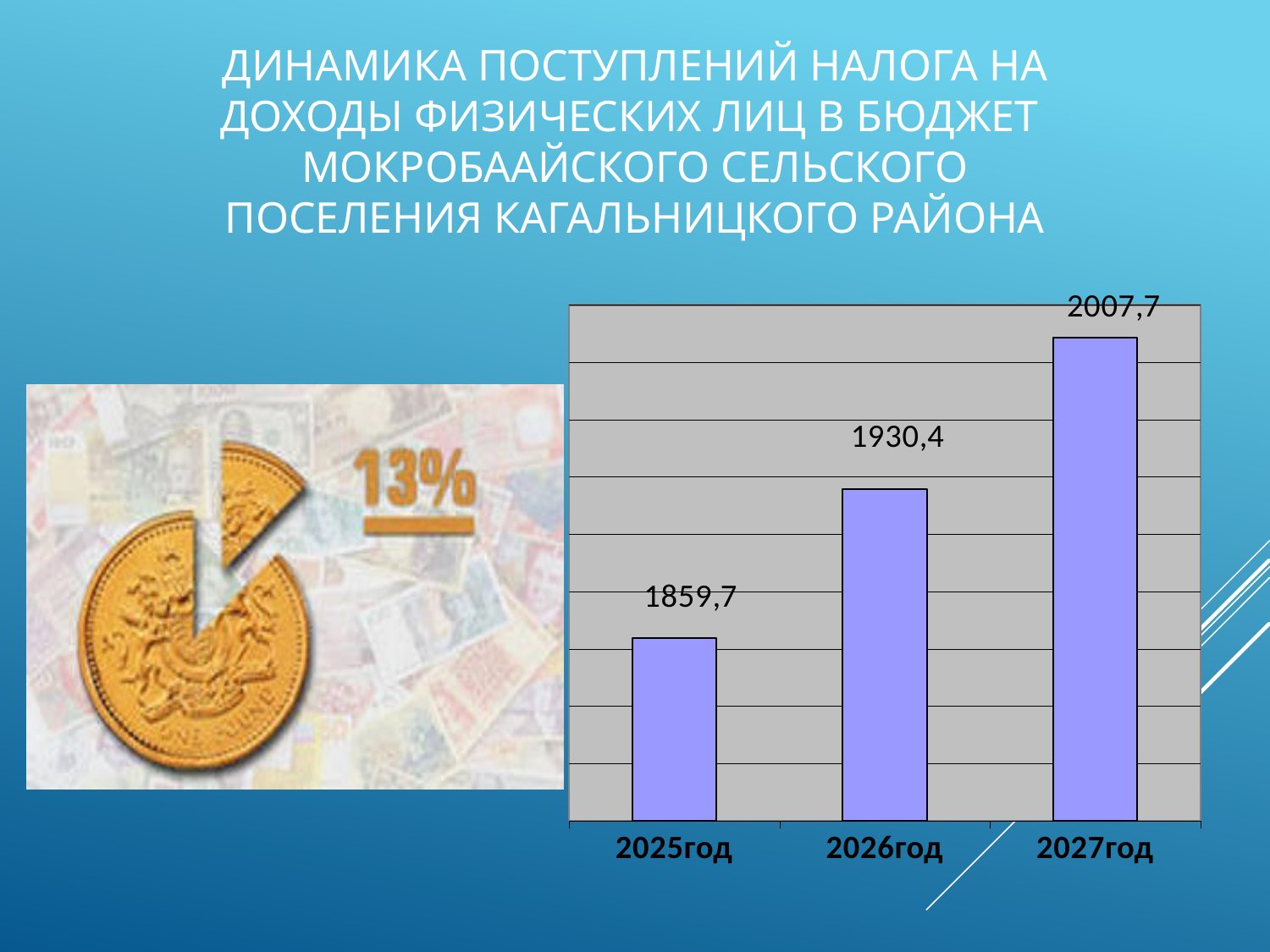
Do the values rise or fall from 2025год to 2027год? Rise Which is larger, the value for 2026год or the value for 2025год? 2026год Which year has the lowest value? 2025год How many years (categories) are shown in the chart? 3 What is the value shown for 2025год? 1859,7 What is the difference between the values for 2026год and 2025год? 70,7 What is the value shown for 2026год? 1930,4 What is the value shown for 2027год? 2007,7 Which year has the highest value? 2027год What kind of chart is shown on the slide? Bar chart What is the difference between the values for 2027год and 2026год? 77,3 What is the difference between the values for 2027год and 2025год? 148